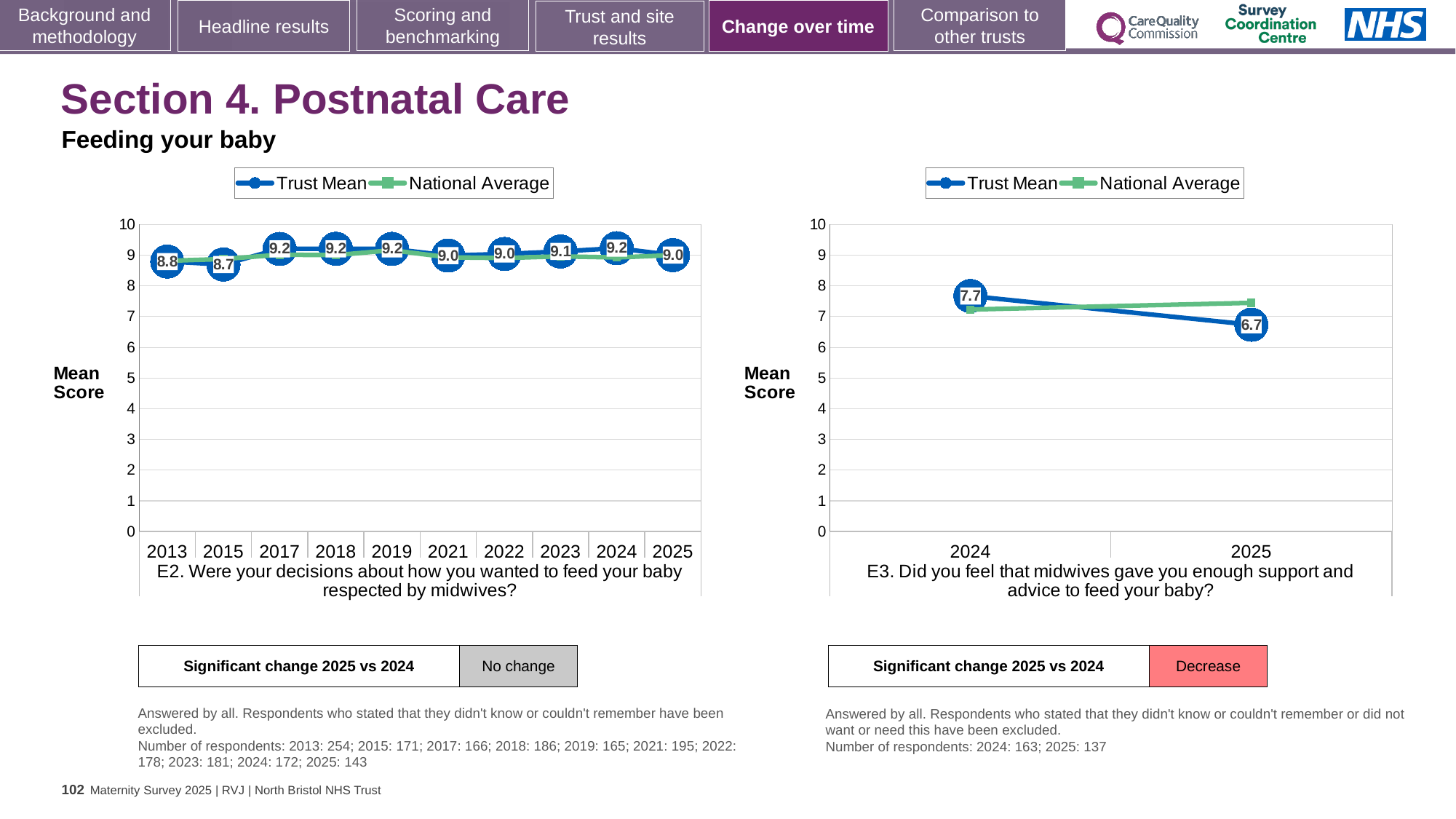
In the left chart (E2), which year has the lowest Trust Mean? 2015 What type of chart is the left chart (E2)? Line chart In the left chart (E2), what is the Trust Mean for 2025? 9.0 In the right chart (E3), what is the difference between the Trust Mean for 2024 and 2025? 1.0 In the right chart (E3), does the Trust Mean rise or fall from 2024 to 2025? Fall How many years are plotted on the x axis of the left chart (E2)? 10 How many series does the legend of the right chart (E3) list? 2 In the left chart (E2), what is the Trust Mean for 2013? 8.8 In the right chart (E3), what is the Trust Mean for 2024? 7.7 In the right chart (E3), what is the Trust Mean for 2025? 6.7 In the right chart (E3), is the National Average for 2025 greater or less than 7? greater In the left chart (E2), is the Trust Mean higher in 2017 or in 2015? 2017